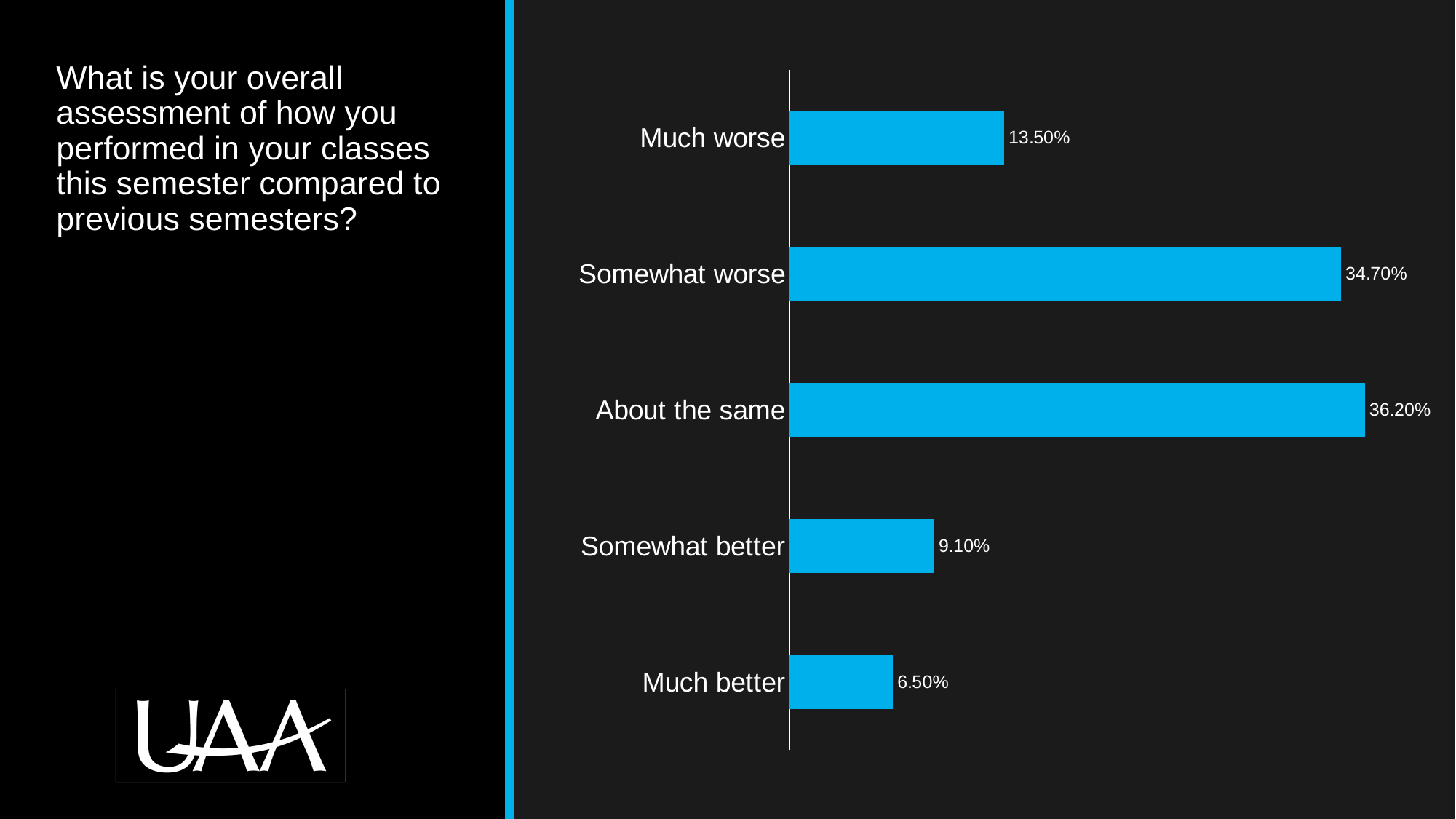
What percentage of respondents said they performed "Much worse"? 13.50% What percentage of respondents said they performed "Somewhat better"? 9.10% What is the value for "Much better"? 6.50% Which category has the highest value? About the same How many categories are shown in the chart? 5 Which category has the lowest value? Much better What kind of chart is shown on the slide? Bar chart What is the difference between the values for "Somewhat worse" and "Much worse"? 21.20% Which is larger, the value for "Much worse" or the value for "Somewhat better"? Much worse What is the difference between the values for "Somewhat better" and "Much better"? 2.60% What is the value for "Somewhat worse"? 34.70% What is the value for "About the same"? 36.20%